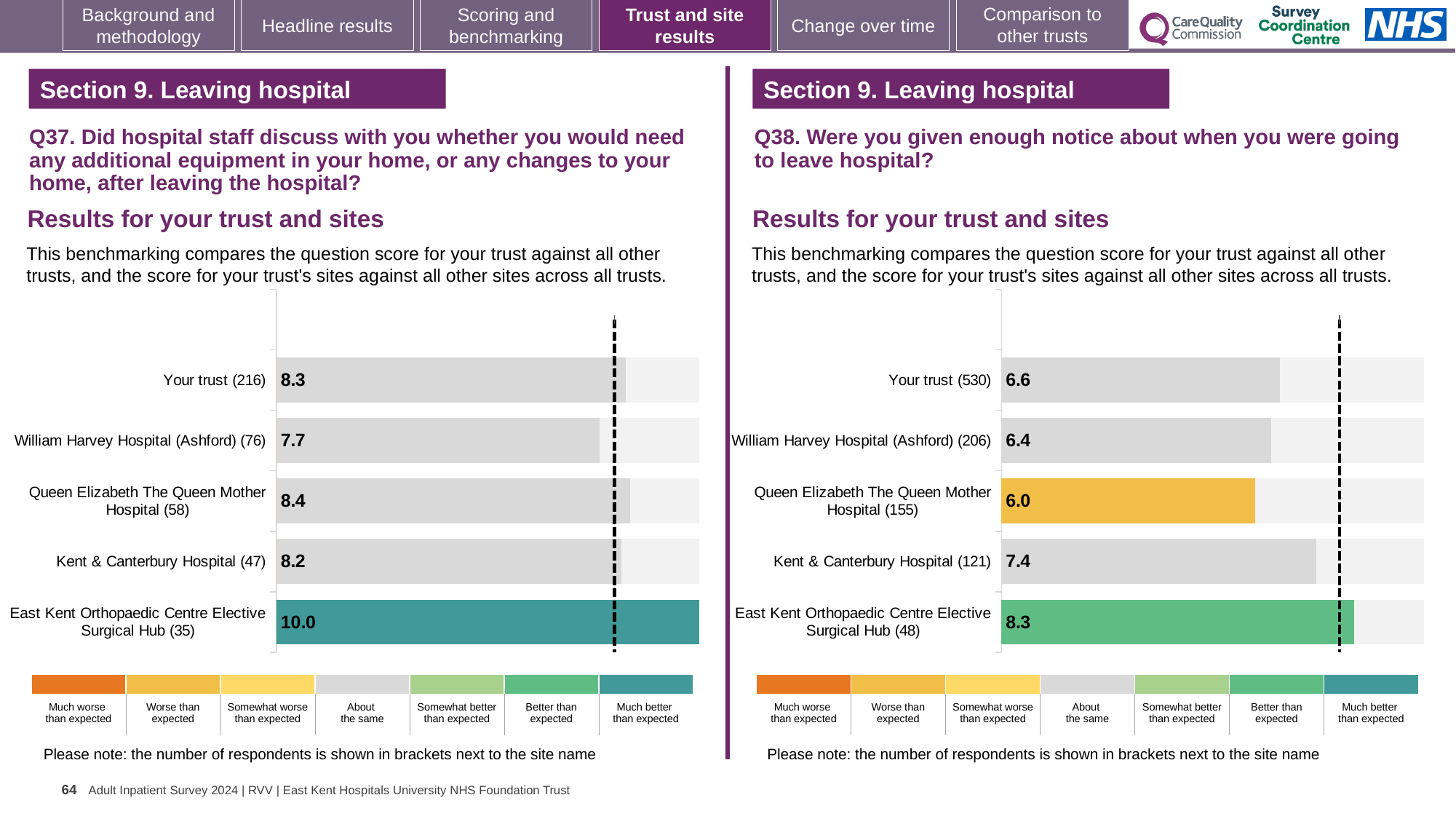
On the Q38 chart (right), which is larger: the score for Your trust or the score for William Harvey Hospital (Ashford)? Your trust On the Q38 chart (right), what is the score for Kent & Canterbury Hospital? 7.4 On the Q37 chart (left), what is the difference between the scores for East Kent Orthopaedic Centre Elective Surgical Hub and Kent & Canterbury Hospital? 1.8 On the Q37 chart (left), what is the score for William Harvey Hospital (Ashford)? 7.7 On the Q37 chart (left), how many bars are plotted? 5 On the Q37 chart (left), which site has the lowest score? William Harvey Hospital (Ashford) On the Q37 chart (left), what is the score for Your trust? 8.3 On the Q38 chart (right), what is the score for Queen Elizabeth The Queen Mother Hospital? 6.0 On the Q38 chart (right), what is the difference between the scores for East Kent Orthopaedic Centre Elective Surgical Hub and Your trust? 1.7 On the Q37 chart (left), which site has the highest score? East Kent Orthopaedic Centre Elective Surgical Hub What type of chart is used on the Q38 chart (right)? Bar chart On the Q38 chart (right), which site has the lowest score? Queen Elizabeth The Queen Mother Hospital